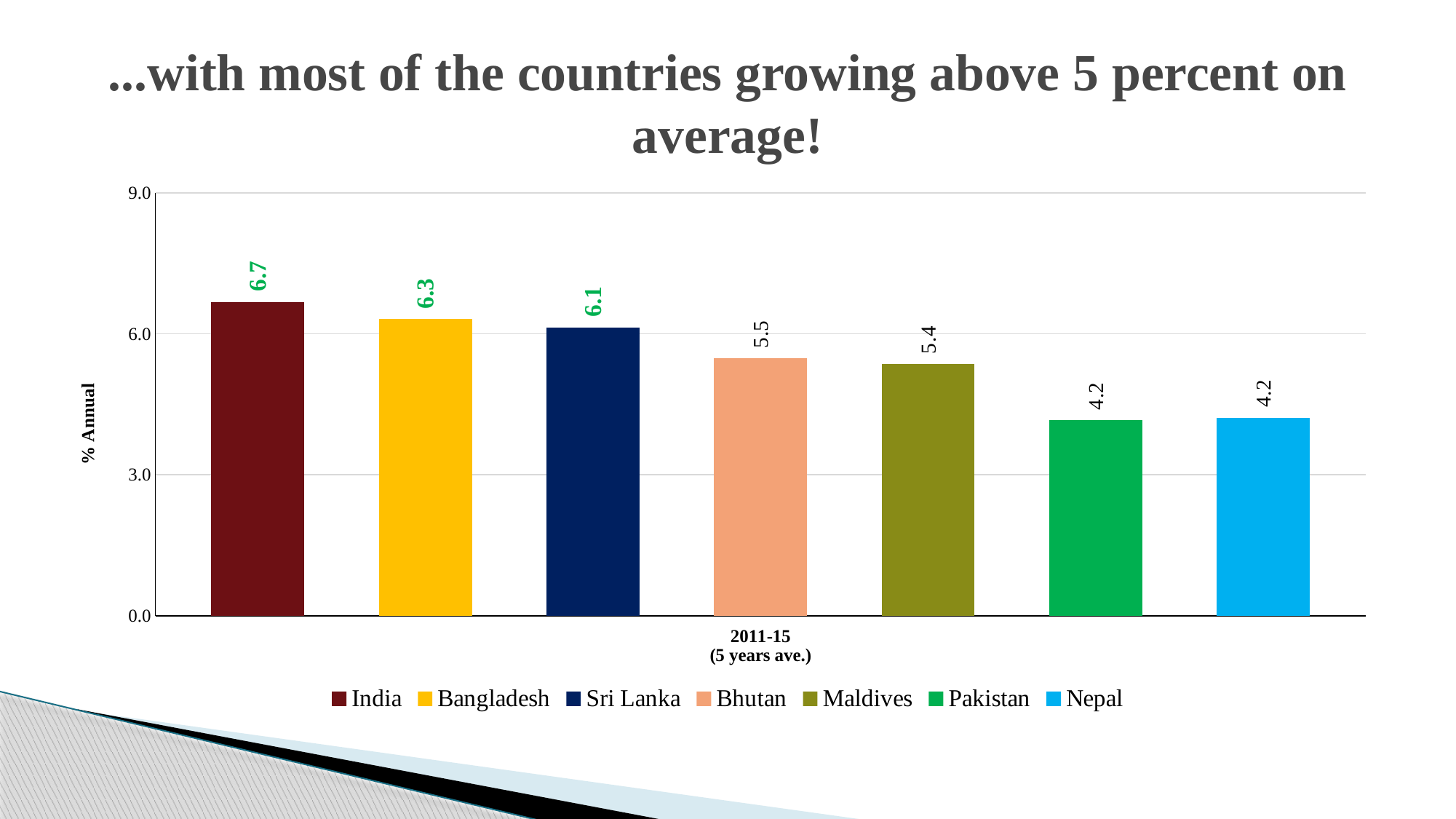
What is the difference between the values for Bangladesh and Pakistan? 2.1 What is the label on the horizontal axis? 2011-15 (5 years ave.) What is the label on the vertical axis? % Annual Which country has the highest value? India What kind of chart is shown on the slide? bar chart Is the value for Maldives greater or less than 6.0? less What is the value for Nepal? 4.2 What is the value for India? 6.7 What is the difference between the values for India and Sri Lanka? 0.6 What is the value for Bhutan? 5.5 Which is larger, the value for Bhutan or the value for Maldives? Bhutan How many series does the legend list? 7